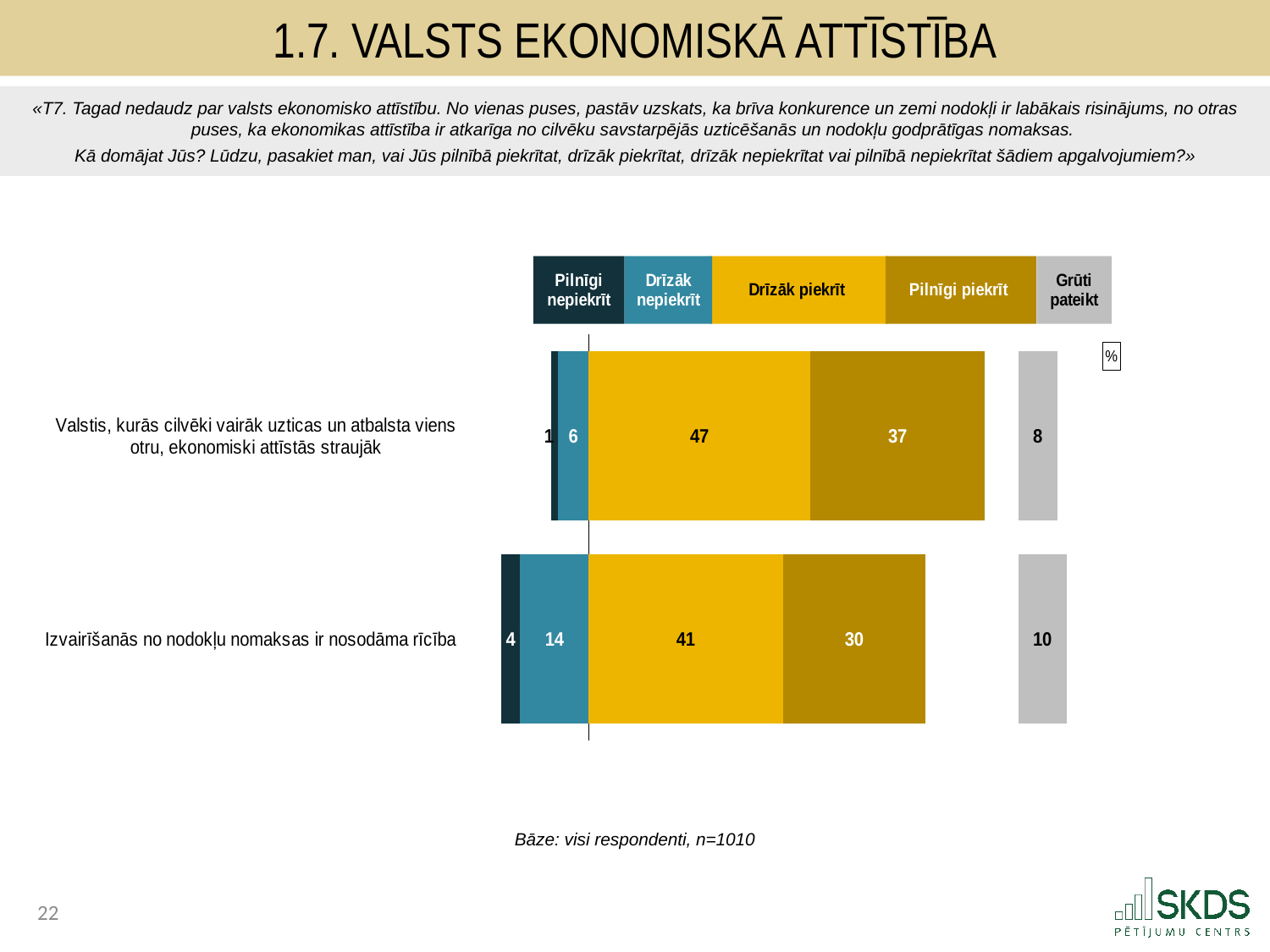
What is the 'Grūti pateikt' value for the statement 'Izvairīšanās no nodokļu nomaksas ir nosodāma rīcība'? 10 What is the 'Drīzāk nepiekrīt' value for the statement 'Valstis, kurās cilvēki vairāk uzticas un atbalsta viens otru, ekonomiski attīstās straujāk'? 6 What kind of chart is shown on the slide? Stacked bar chart What is the difference between the 'Drīzāk piekrīt' values of the two statements? 6 How many statements (categories) are plotted in the chart? 2 Which response category has the largest value for the statement 'Izvairīšanās no nodokļu nomaksas ir nosodāma rīcība'? Drīzāk piekrīt What is the combined 'Drīzāk piekrīt' and 'Pilnīgi piekrīt' total for the statement 'Valstis, kurās cilvēki vairāk uzticas un atbalsta viens otru, ekonomiski attīstās straujāk'? 84 What is the base (number of respondents) stated below the chart? n=1010 How many response categories does the legend list? 5 Which statement has the higher 'Pilnīgi nepiekrīt' value? Izvairīšanās no nodokļu nomaksas ir nosodāma rīcība What is the 'Drīzāk piekrīt' value for the statement 'Valstis, kurās cilvēki vairāk uzticas un atbalsta viens otru, ekonomiski attīstās straujāk'? 47 What is the 'Pilnīgi piekrīt' value for the statement 'Izvairīšanās no nodokļu nomaksas ir nosodāma rīcība'? 30